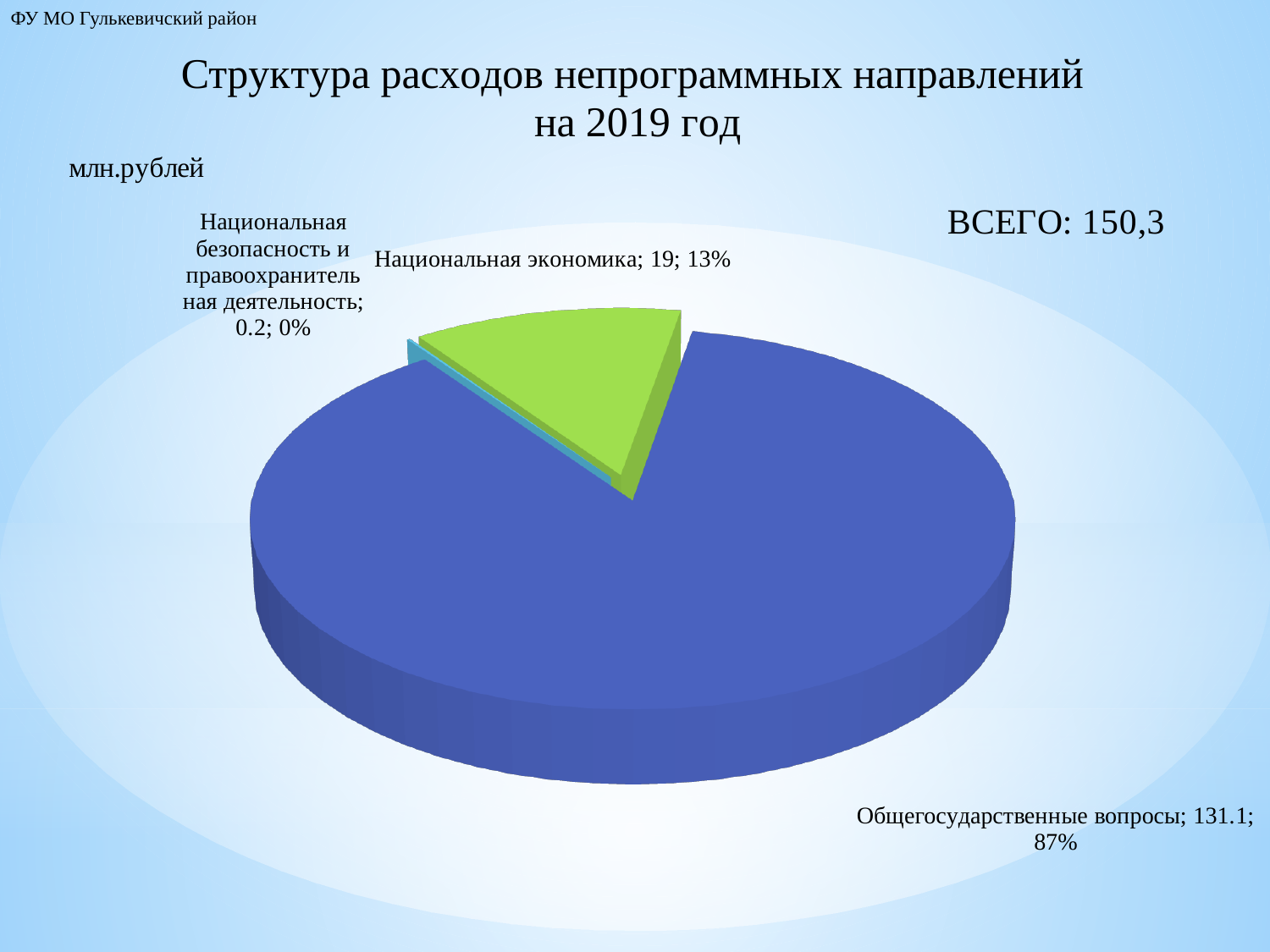
Which is larger, Национальная экономика or Национальная безопасность и правоохранительная деятельность? Национальная экономика Which category has the largest slice? Общегосударственные вопросы What share of the pie does Общегосударственные вопросы take? 87% What is the value for Национальная экономика? 19 What is the value for Общегосударственные вопросы? 131.1 What total (ВСЕГО) is stated on the slide? 150,3 What share of the pie does Национальная экономика take? 13% What kind of chart is shown on the slide? pie chart Which category has the smallest slice? Национальная безопасность и правоохранительная деятельность How many categories are shown in the pie chart? 3 What is the value for Национальная безопасность и правоохранительная деятельность? 0.2 What is the difference between the values for Общегосударственные вопросы and Национальная экономика? 112.1